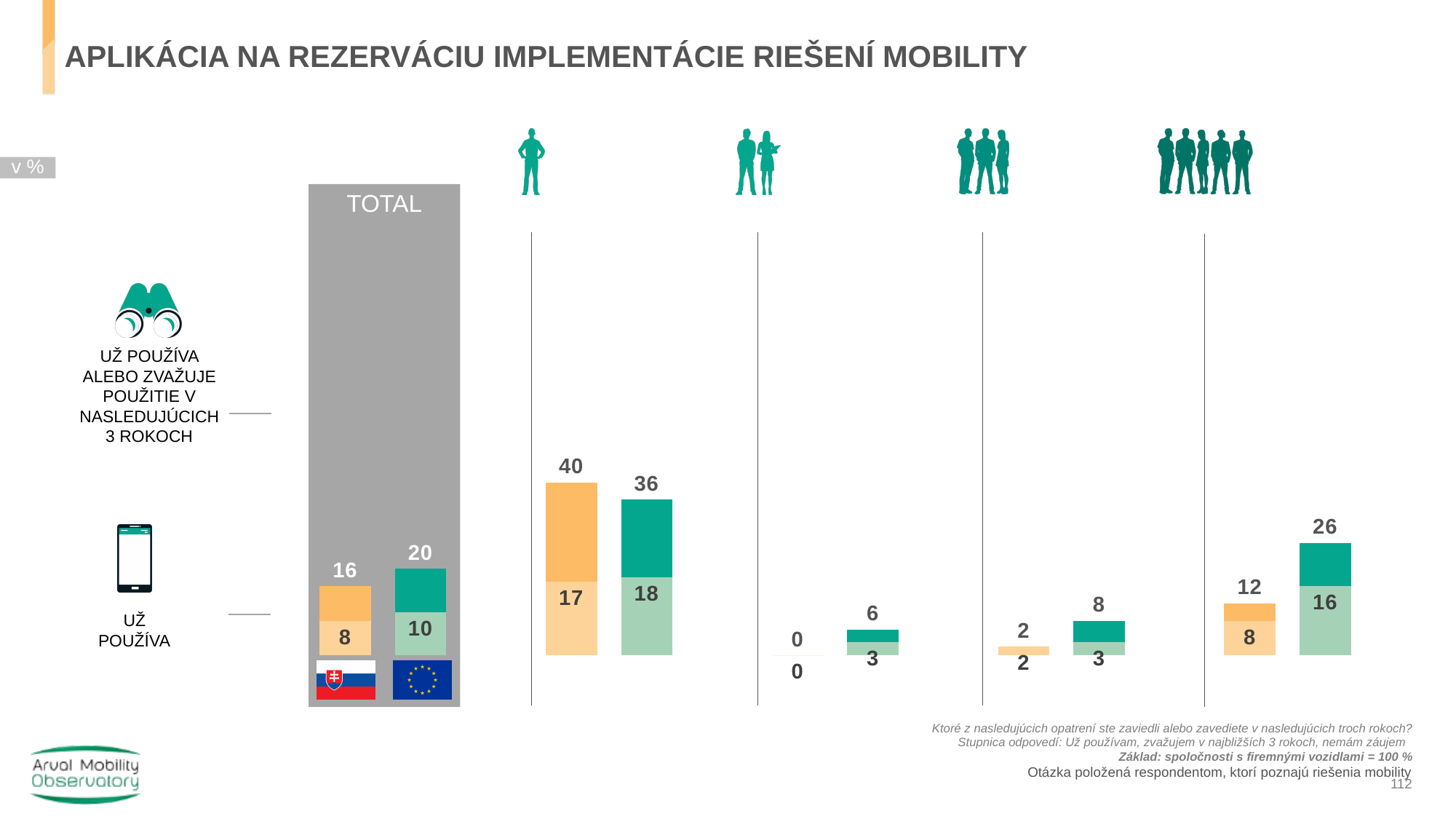
What unit are the values on the chart expressed in, according to the label at the top left? % In the rightmost company-size group, what is the difference between the EU value (26) and the Slovakia value (12) for 'už používa alebo zvažuje použitie v nasledujúcich 3 rokoch'? 14 In the first company-size group (single-person icon), which is larger for 'už používa alebo zvažuje použitie v nasledujúcich 3 rokoch': Slovakia or the EU? Slovakia In the TOTAL column, which is larger for 'už používa alebo zvažuje použitie v nasledujúcich 3 rokoch': Slovakia or the EU? EU How many company-size groups (person icons) are shown to the right of the TOTAL column? 4 Across all groups on the slide, which bar has the highest value for 'už používa alebo zvažuje použitie v nasledujúcich 3 rokoch'? Slovakia in the first company-size group (40) What type of chart is shown on the slide? Bar chart In the largest company-size group (five-person icon, rightmost), what is the EU value for 'už používa'? 16 In the second company-size group (two-person icon), what is the Slovakia value for 'už používa'? 0 In the TOTAL column, what is the value for Slovakia (orange bar) for 'už používa alebo zvažuje použitie v nasledujúcich 3 rokoch'? 16 In the TOTAL column, what is the value for the EU (green bar) for 'už používa'? 10 In the first company-size group to the right of TOTAL (single-person icon), what is the Slovakia value for 'už používa alebo zvažuje použitie v nasledujúcich 3 rokoch'? 40